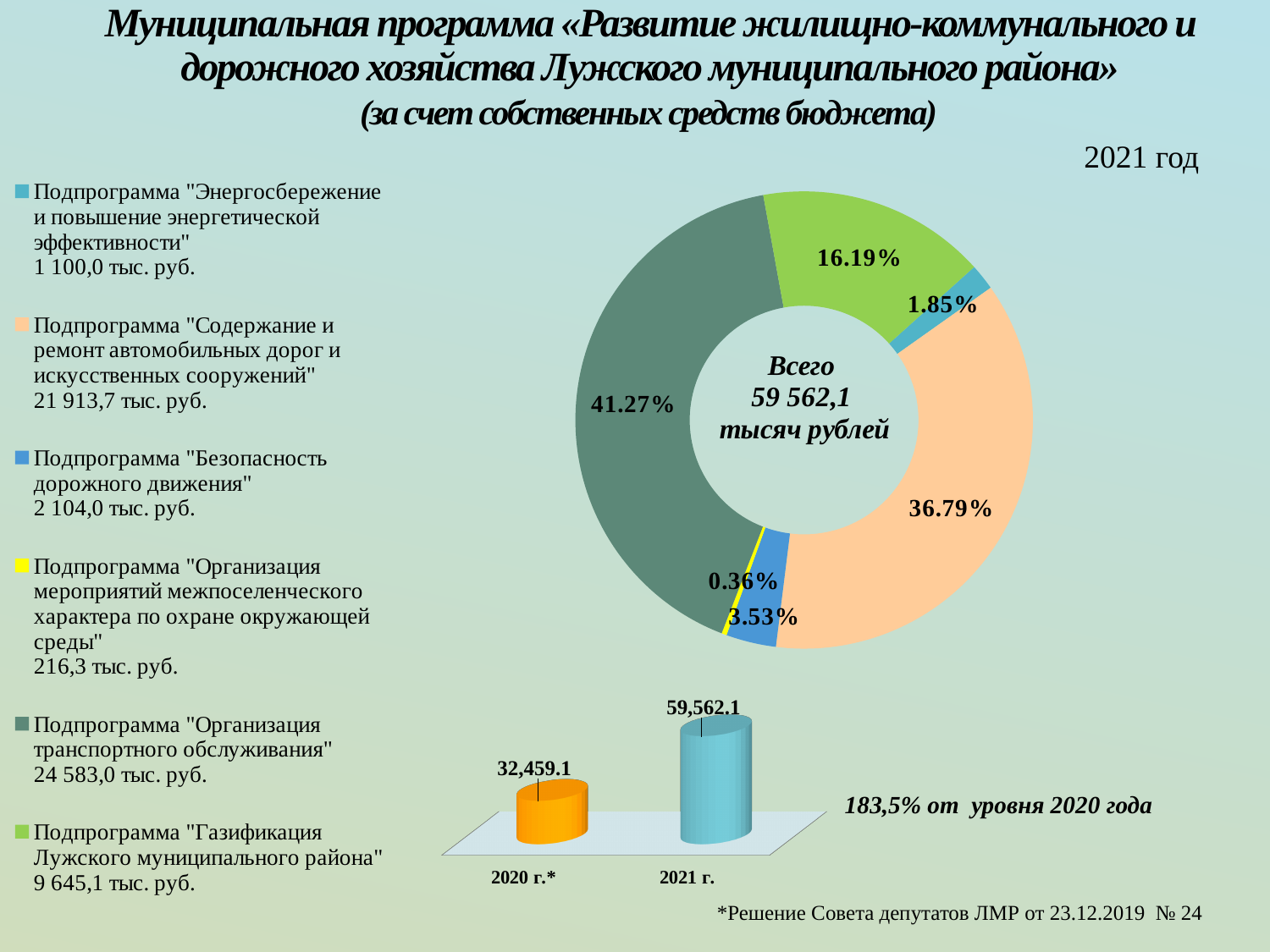
On the bar chart at the bottom, what is the value for 2020 г.*? 32,459.1 On the bar chart at the bottom, what is the value for 2021 г.? 59,562.1 On the doughnut chart, what share is shown for the subprogram "Газификация Лужского муниципального района"? 16.19% On the doughnut chart, what share is shown for the subprogram "Безопасность дорожного движения"? 3.53% On the bar chart at the bottom, what is the difference between the 2021 г. and 2020 г.* values? 27,103.0 On the doughnut chart, which subprogram has the smallest share? Подпрограмма "Организация мероприятий межпоселенческого характера по охране окружающей среды" (0.36%) What kind of chart is the chart at the bottom of the slide? Bar chart On the doughnut chart, what share is shown for the subprogram "Содержание и ремонт автомобильных дорог и искусственных сооружений"? 36.79% On the doughnut chart, what total amount is shown in the centre? 59 562,1 тысяч рублей How many subprograms does the legend of the doughnut chart list? 6 On the doughnut chart, which subprogram has the largest share? Подпрограмма "Организация транспортного обслуживания" (41.27%) On the doughnut chart, what share is shown for the subprogram "Организация транспортного обслуживания"? 41.27%